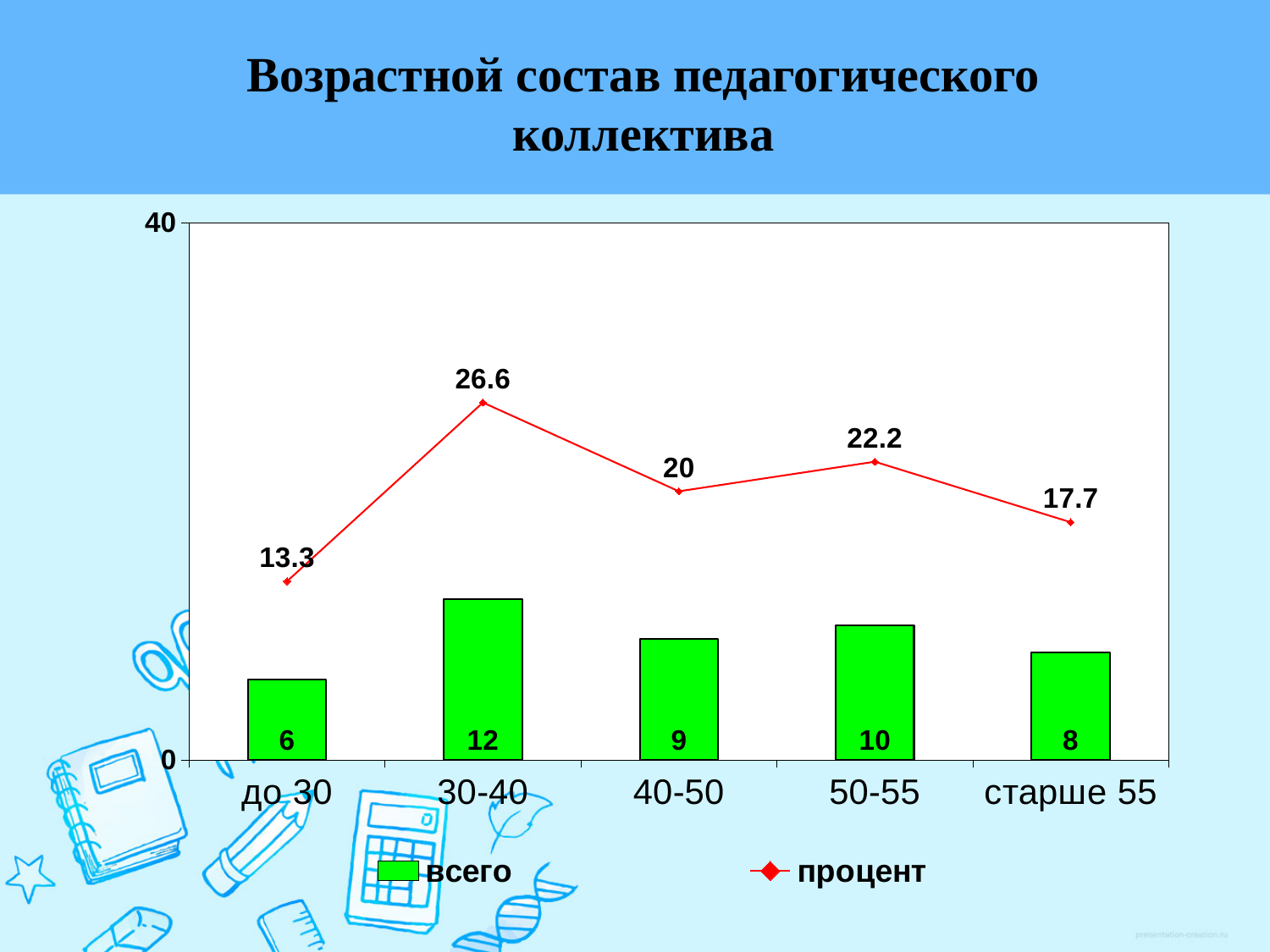
What colour are the bars for the "всего" series? green How many series does the legend list? 2 What is the value of "всего" for the "до 30" age group? 6 What is the value of "процент" for the "старше 55" age group? 17.7 How many age groups are shown on the x axis? 5 What kind of chart is used for the "всего" series? bar chart What is the value of "всего" for the "30-40" age group? 12 What is the difference between the "всего" values for "30-40" and "40-50"? 3 Which age group has the highest "процент" value? 30-40 Which age group has the lowest "всего" value? до 30 Which is larger: the "процент" value for "50-55" or for "40-50"? 50-55 Does the "процент" line rise or fall from "30-40" to "40-50"? fall